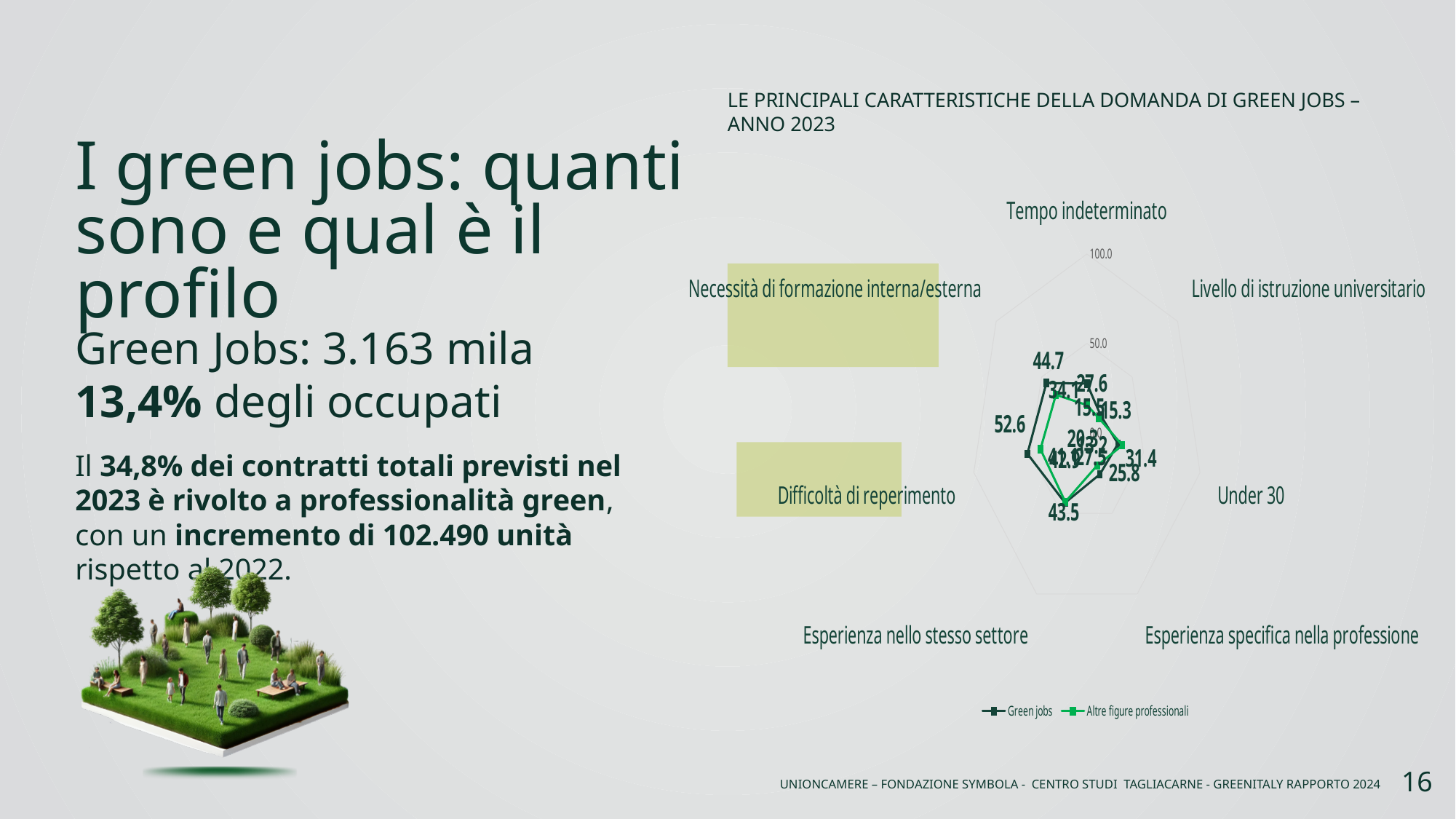
What is the value for Green jobs on the 'Necessità di formazione interna/esterna' axis? 44.7 How many series does the legend of the radar chart list? 2 On which axis does the Green jobs series reach its highest value? Difficoltà di reperimento On the 'Tempo indeterminato' axis, which series has the larger value, Green jobs or Altre figure professionali? Green jobs How many characteristics (axes) does the radar chart show? 7 What kind of chart is shown on the slide? Radar chart What is the value for Green jobs on the 'Tempo indeterminato' axis? 27.6 Is the Green jobs value for 'Tempo indeterminato' greater or less than 50? less What is the title of the chart on the slide? LE PRINCIPALI CARATTERISTICHE DELLA DOMANDA DI GREEN JOBS – ANNO 2023 Is the Green jobs value for 'Necessità di formazione interna/esterna' greater or less than 50? less What are the two series named in the legend of the radar chart? Green jobs; Altre figure professionali